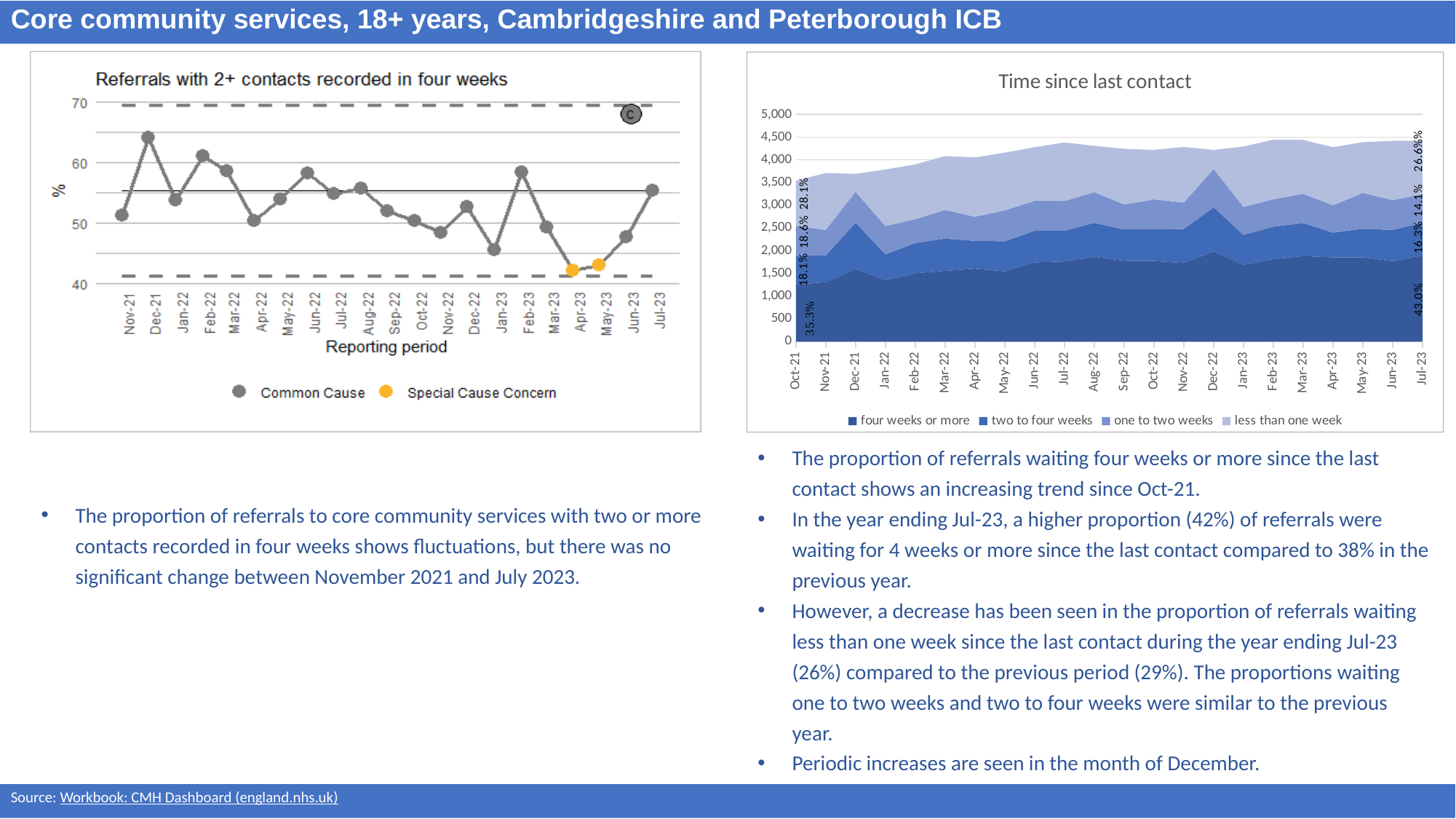
In the right chart 'Time since last contact', what percentage label is shown for 'less than one week' at Oct-21? 28.1% In the left chart 'Referrals with 2+ contacts recorded in four weeks', which reporting period has the highest value? Dec-21 How many series does the legend of the right chart 'Time since last contact' list? 4 What kind of chart is the left chart titled 'Referrals with 2+ contacts recorded in four weeks'? Line chart In the left chart 'Referrals with 2+ contacts recorded in four weeks', how many points are marked as Special Cause Concern? 2 In the left chart 'Referrals with 2+ contacts recorded in four weeks', is the value for Dec-21 greater or less than 60? greater What kind of chart is the right chart titled 'Time since last contact'? Stacked area chart In the right chart 'Time since last contact', is the total at Jul-23 greater or less than 4,000? greater How many reporting periods are plotted on the x axis of the left chart 'Referrals with 2+ contacts recorded in four weeks'? 21 How many series does the legend of the left chart 'Referrals with 2+ contacts recorded in four weeks' list? 2 In the right chart 'Time since last contact', what percentage label is shown for 'four weeks or more' at Jul-23? 43.0% In the left chart 'Referrals with 2+ contacts recorded in four weeks', is the value for Apr-23 greater or less than 50? less